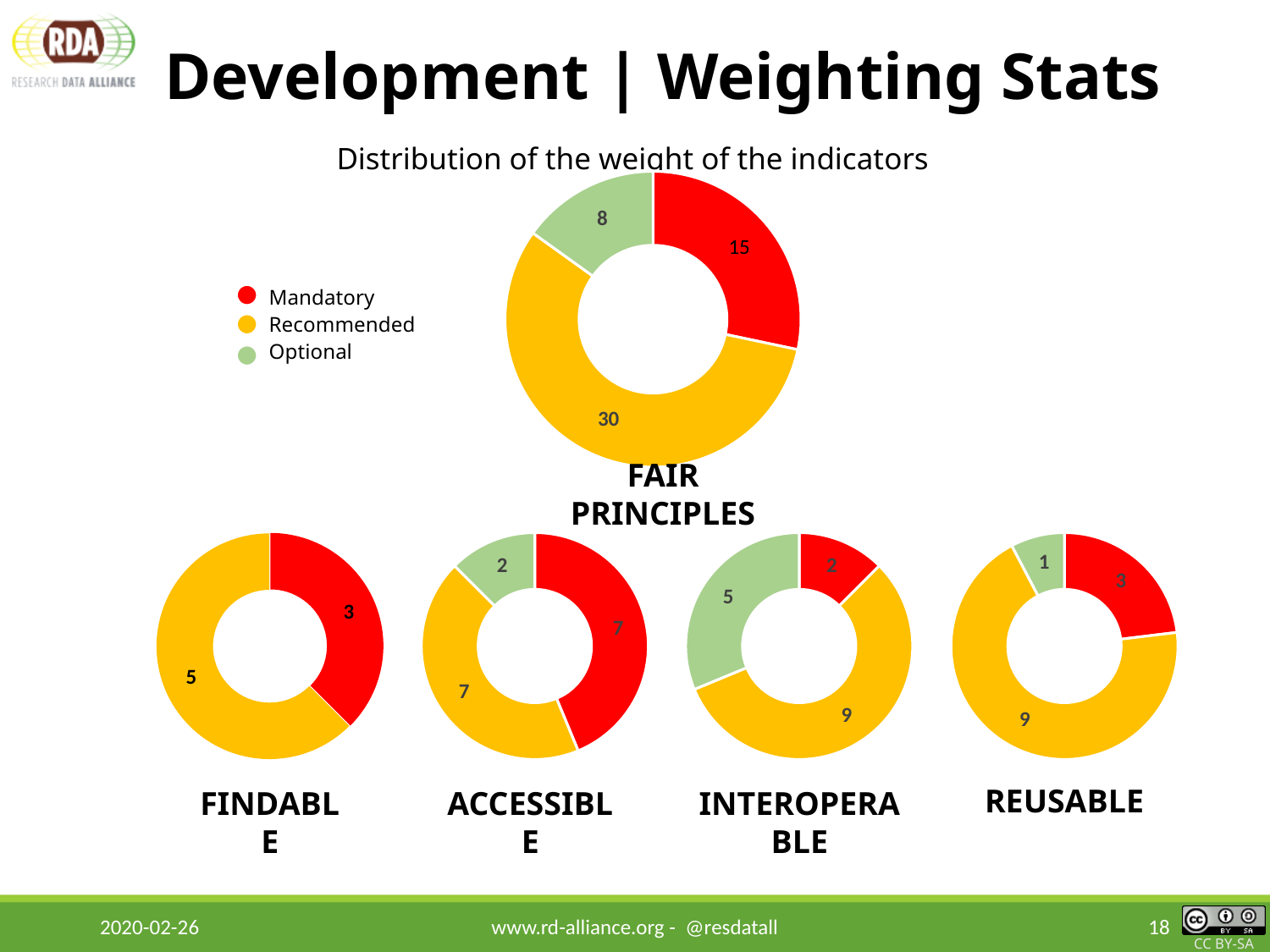
What kind of chart is the FAIR PRINCIPLES chart? Doughnut chart In the REUSABLE chart, what is the value for Optional? 1 In the FAIR PRINCIPLES chart, what is the value for Mandatory? 15 In the FAIR PRINCIPLES chart, which category has the lowest value? Optional In the INTEROPERABLE chart, is the value for Optional larger or smaller than the value for Mandatory? larger In the FAIR PRINCIPLES chart, what is the value for Recommended? 30 In the INTEROPERABLE chart, which category has the highest value? Recommended In the FINDABLE chart, what is the difference between Recommended and Mandatory? 2 How many series does the legend list? 3 In the FAIR PRINCIPLES chart, what is the total of all three segments? 53 In the FINDABLE chart, what is the value for Recommended? 5 In the ACCESSIBLE chart, what is the value for Optional? 2